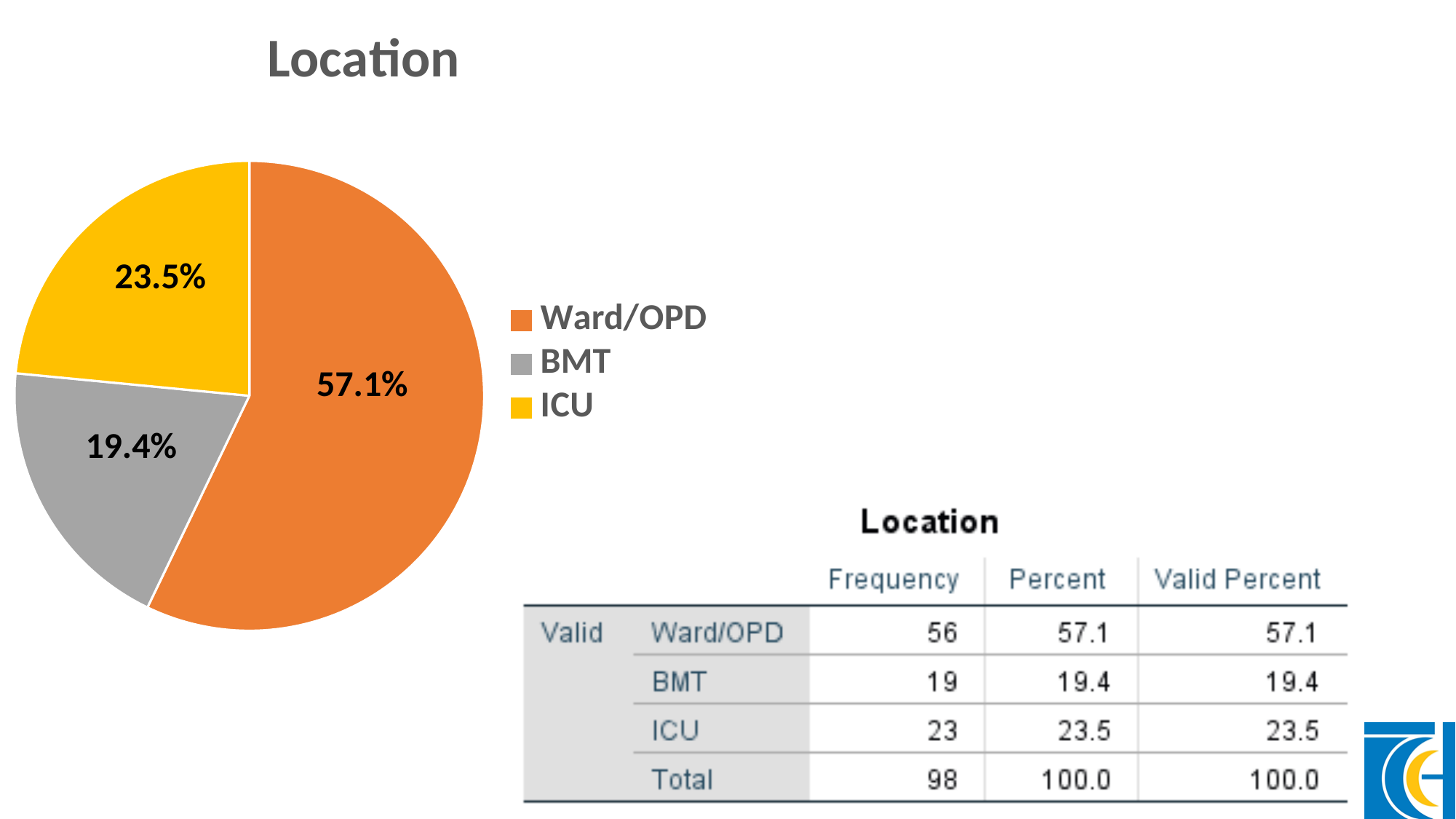
What share of the pie does Ward/OPD represent? 57.1% What share of the pie does ICU represent? 23.5% Which category has the smallest slice of the pie? BMT What is the difference in percentage points between the Ward/OPD slice and the ICU slice? 33.6 What share of the pie does BMT represent? 19.4% Which is larger, the ICU slice or the BMT slice? ICU How many categories does the pie chart show? 3 What type of chart is shown on the slide? pie chart What is the title of the chart? Location What is the difference in percentage points between the ICU slice and the BMT slice? 4.1 Which category has the largest slice of the pie? Ward/OPD Which colour represents ICU in the pie chart? yellow